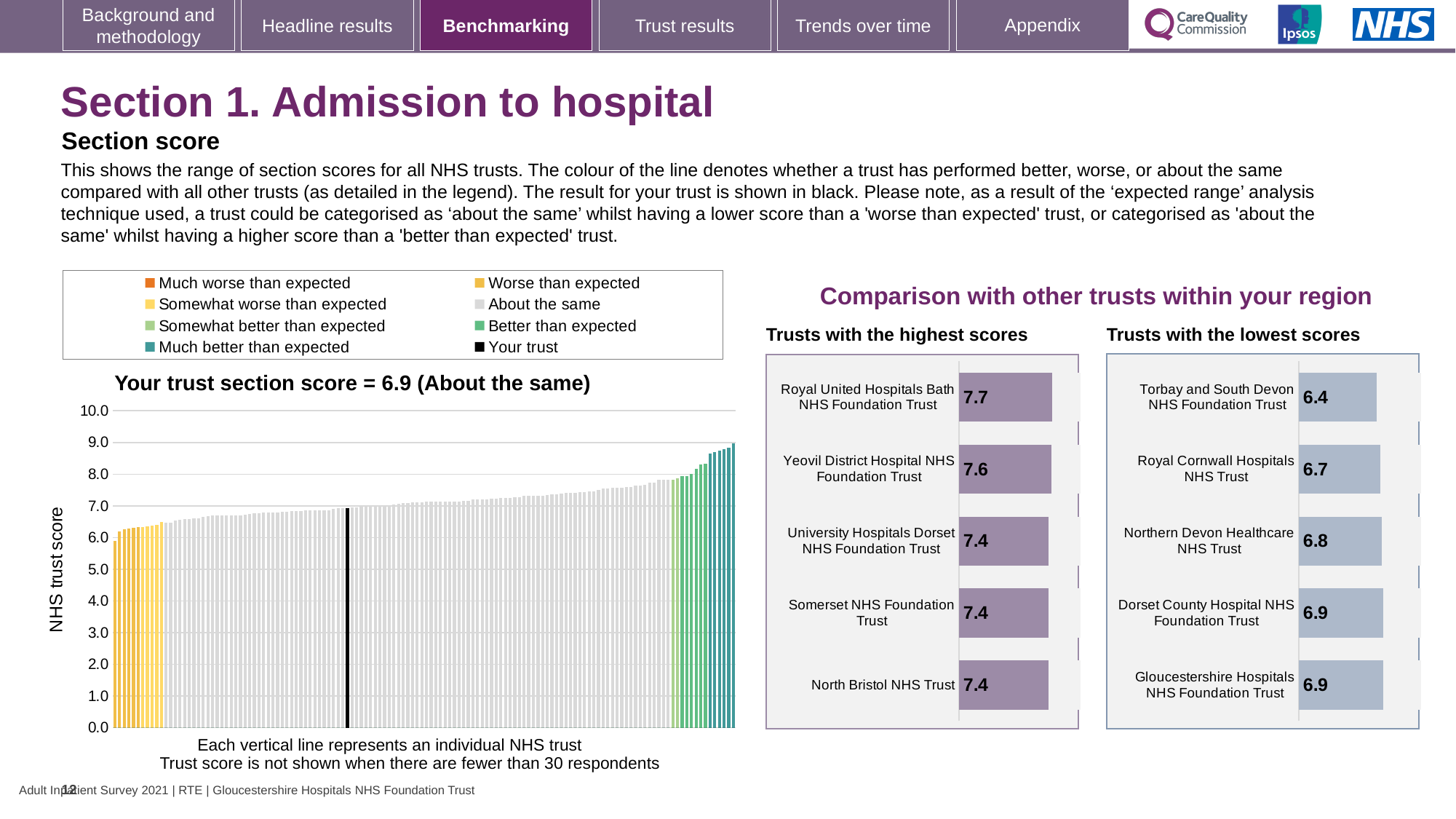
On the 'Trusts with the highest scores' chart, which trust has the highest score? Royal United Hospitals Bath NHS Foundation Trust On the 'Trusts with the lowest scores' chart, which trust has the lowest score? Torbay and South Devon NHS Foundation Trust On the 'Trusts with the highest scores' chart, what is the score for Royal United Hospitals Bath NHS Foundation Trust? 7.7 On the 'Your trust section score' chart, do the trust scores rise or fall from left to right along the x axis? rise On the 'Trusts with the lowest scores' chart, what is the score for Royal Cornwall Hospitals NHS Trust? 6.7 On the 'Your trust section score' chart, is the value for your trust greater or less than 5.0? greater On the 'Your trust section score' chart, how many entries does the legend list? 8 On the 'Trusts with the highest scores' chart, what is the difference between the scores of Royal United Hospitals Bath NHS Foundation Trust and Yeovil District Hospital NHS Foundation Trust? 0.1 On the 'Trusts with the highest scores' chart, how many trusts are shown? 5 On the 'Your trust section score' chart, what kind of chart is shown? bar chart On the 'Your trust section score' chart, what is the section score for your trust? 6.9 On the 'Trusts with the lowest scores' chart, which has the larger score, Torbay and South Devon NHS Foundation Trust or Northern Devon Healthcare NHS Trust? Northern Devon Healthcare NHS Trust